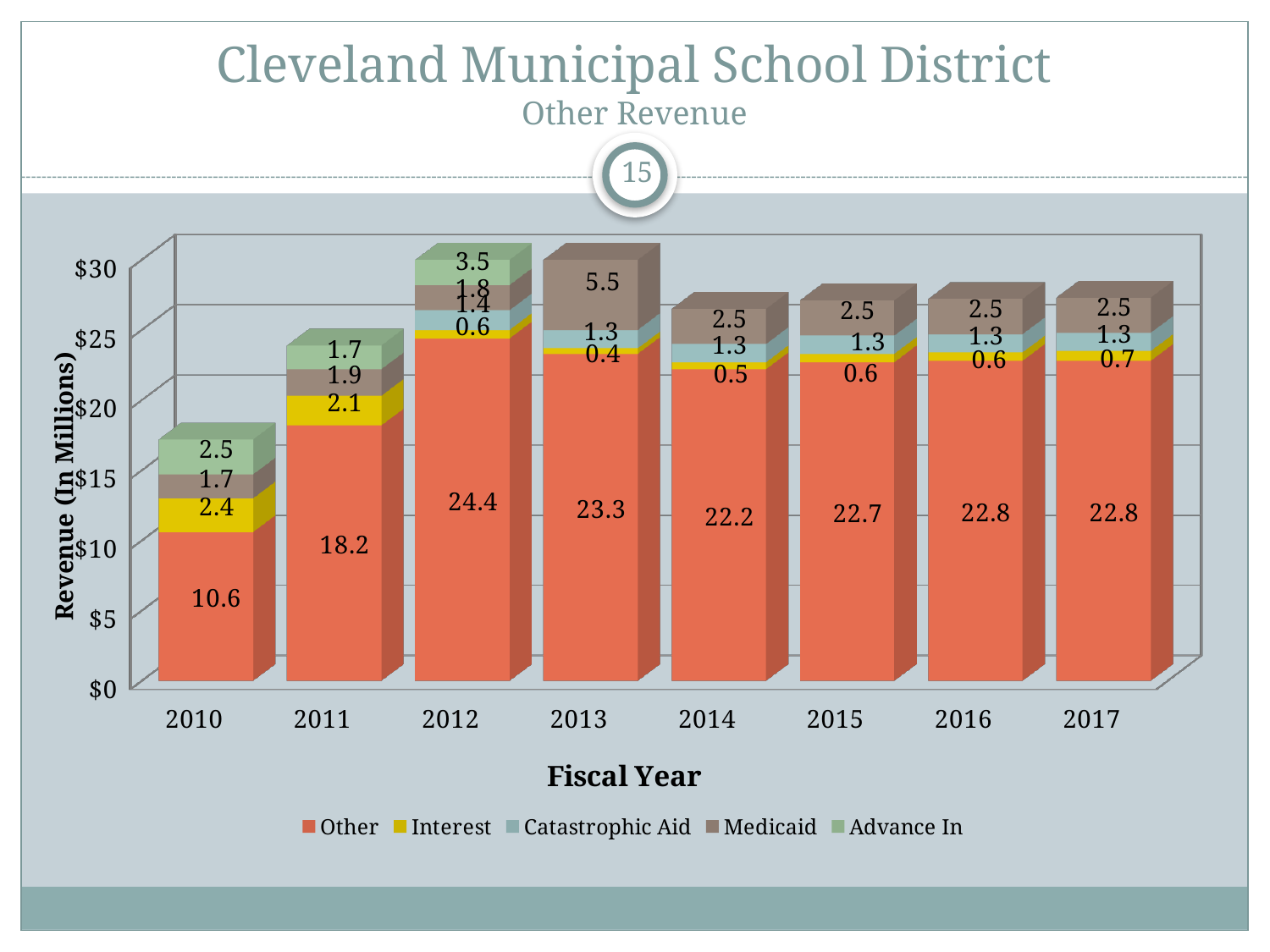
What is the Interest value for fiscal year 2010? 2.4 How many series does the legend list? 5 Which fiscal year has the larger Medicaid value, 2013 or 2014? 2013 What is the value of the Other series for fiscal year 2012? 24.4 Which fiscal year has the lowest value for the Other series? 2010 What is the title of the x axis? Fiscal Year How many fiscal years are shown on the x axis? 8 What kind of chart is shown on the slide? Stacked bar chart Which fiscal year has the highest value for the Other series? 2012 What is the Advance In value for fiscal year 2012? 3.5 What is the difference between the Other value in 2012 and the Other value in 2010? 13.8 What is the Medicaid value for fiscal year 2013? 5.5